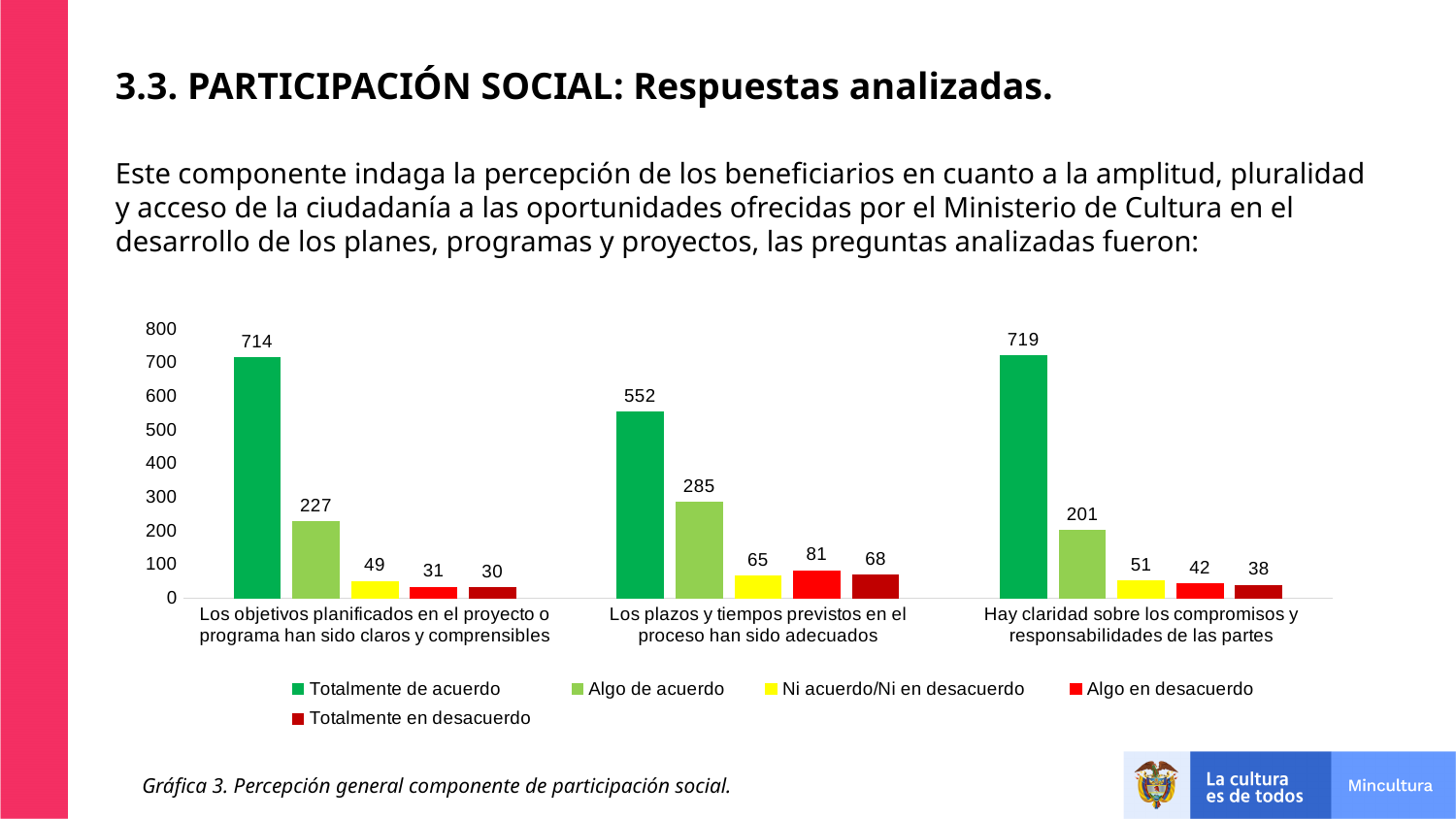
What is the value for 'Totalmente en desacuerdo' for 'Hay claridad sobre los compromisos y responsabilidades de las partes'? 38 What is the value for 'Totalmente de acuerdo' for 'Los objetivos planificados en el proyecto o programa han sido claros y comprensibles'? 714 What is the difference between 'Totalmente de acuerdo' and 'Algo de acuerdo' for 'Los plazos y tiempos previstos en el proceso han sido adecuados'? 267 How many series does the legend list? 5 Which is larger for 'Los plazos y tiempos previstos en el proceso han sido adecuados': 'Algo en desacuerdo' or 'Totalmente en desacuerdo'? Algo en desacuerdo Which category has the lowest value for 'Totalmente de acuerdo'? Los plazos y tiempos previstos en el proceso han sido adecuados What kind of chart is shown on the slide? bar chart What is the value for 'Algo de acuerdo' for 'Los plazos y tiempos previstos en el proceso han sido adecuados'? 285 How many categories are shown on the x axis? 3 Is the value for 'Algo de acuerdo' for 'Hay claridad sobre los compromisos y responsabilidades de las partes' greater or less than 300? less What is the caption of the chart? Gráfica 3. Percepción general componente de participación social. Which category has the highest value for 'Totalmente de acuerdo'? Hay claridad sobre los compromisos y responsabilidades de las partes